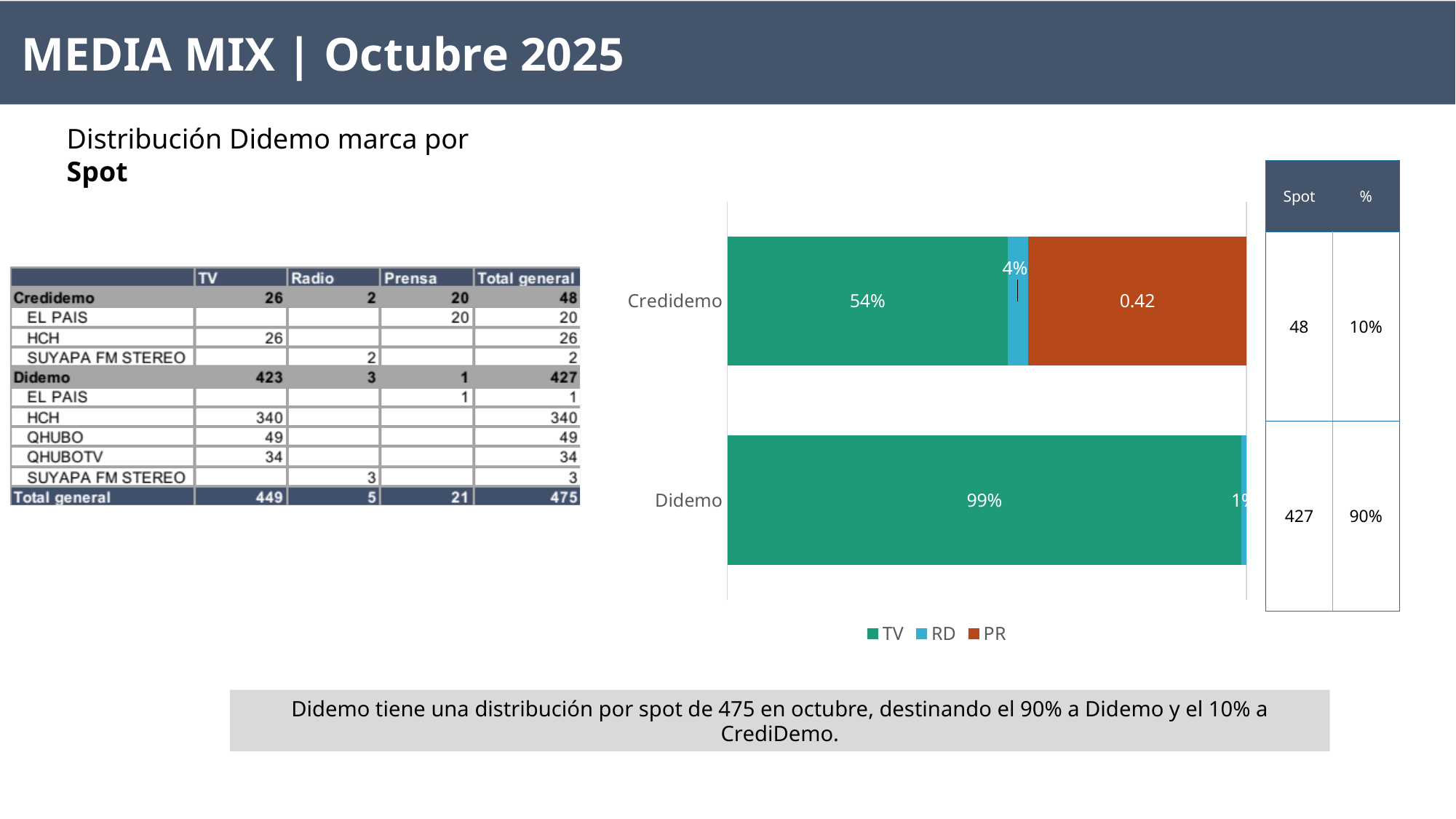
For Credidemo, which is larger, the TV segment or the PR segment? TV Which category has the higher TV share, Credidemo or Didemo? Didemo What type of chart is used to show the distribution by brand? Stacked bar chart What are the three entries in the chart legend? TV, RD, PR What is the RD share shown for Credidemo in the stacked bar chart? 4% What is the TV share shown for Didemo in the stacked bar chart? 99% What is the difference in percentage points between the TV share of Didemo and the TV share of Credidemo? 45 percentage points What is the TV share shown for Credidemo in the stacked bar chart? 54% How many series does the chart legend list? 3 Which series has the smallest segment in the Credidemo bar? RD What value is printed on the PR segment of the Credidemo bar? 0.42 How many categories (bars) are shown in the stacked bar chart? 2